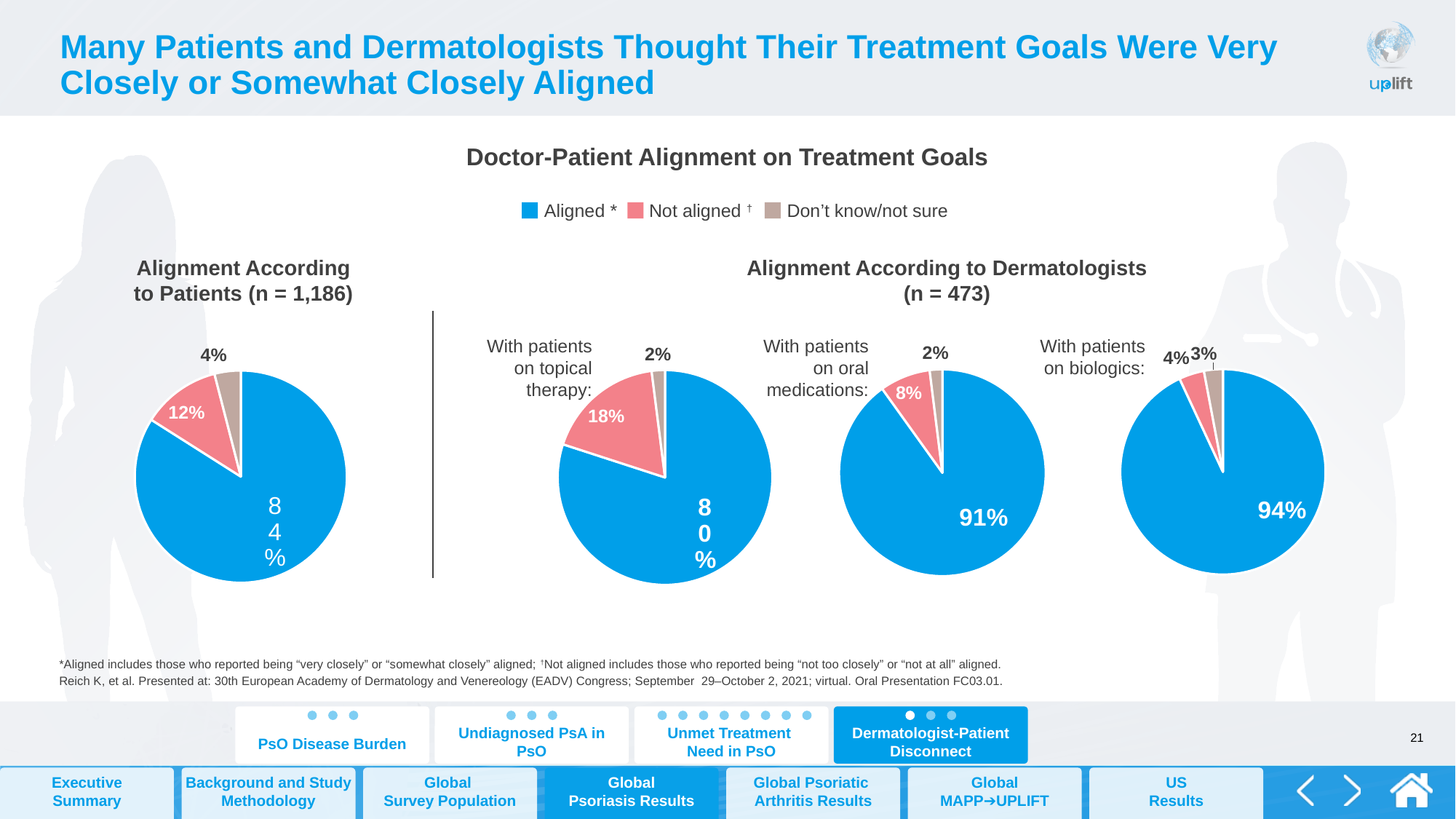
How many series does the legend list for the pie charts? 3 Among the three dermatologist pie charts, which patient group has the highest Aligned share? With patients on biologics Is the Not aligned share larger in the dermatologists' pie chart for patients on topical therapy or for patients on oral medications? Patients on topical therapy Among the three dermatologist pie charts, which patient group has the lowest Aligned share? With patients on topical therapy What type of chart is used to show Doctor-Patient Alignment on Treatment Goals? Pie chart In the dermatologists' pie chart for patients on topical therapy, what percentage were Not aligned? 18% What is the difference between the Aligned share in the patients' pie chart (84%) and the Aligned share in the dermatologists' pie chart for patients on topical therapy (80%)? 4 percentage points In the dermatologists' pie chart for patients on biologics, what percentage were Aligned? 94% In the dermatologists' pie chart for patients on oral medications, what percentage were Aligned? 91% In the 'Alignment According to Patients' pie chart, what percentage were Not aligned? 12% In the 'Alignment According to Patients' pie chart, what percentage of patients were Aligned? 84% In the dermatologists' pie chart for patients on biologics, what percentage answered Don't know/not sure? 3%